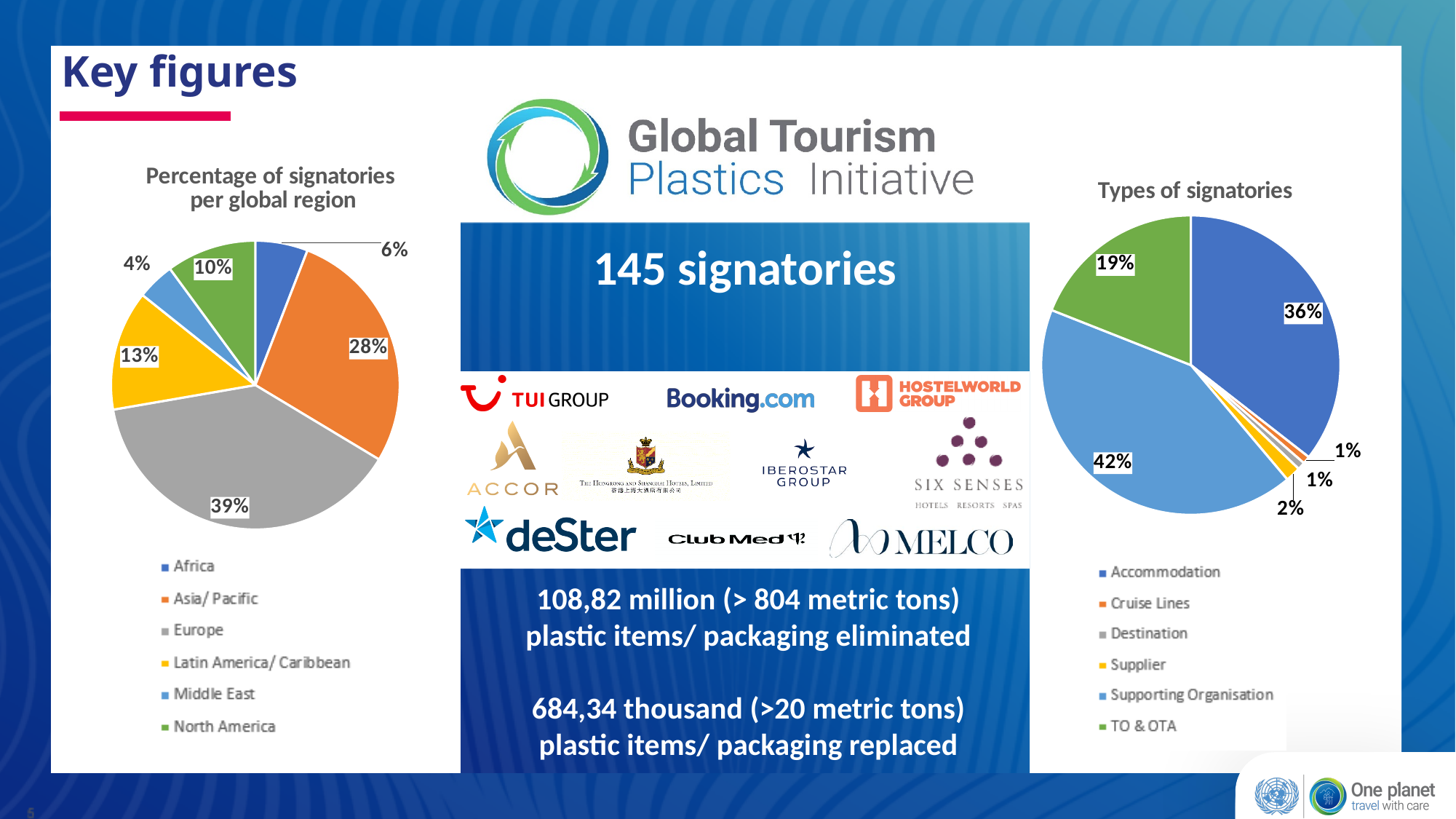
In the 'Percentage of signatories per global region' chart, which region has the smallest share of signatories? Middle East In the 'Percentage of signatories per global region' chart, how many regions are shown? 6 In the 'Types of signatories' chart, what percentage of signatories are TO & OTA? 19% In the 'Types of signatories' chart, what percentage of signatories are Supporting Organisations? 42% In the 'Types of signatories' chart, what is the difference in percentage points between Supporting Organisation and Accommodation? 6 What type of chart is used for 'Types of signatories'? Pie chart In the 'Percentage of signatories per global region' chart, how many percentage points higher is Latin America/ Caribbean than Africa? 7 In the 'Percentage of signatories per global region' chart, what percentage of signatories are from Asia/ Pacific? 28% In the 'Types of signatories' chart, which is larger: Accommodation or TO & OTA? Accommodation In the 'Percentage of signatories per global region' chart, which region has the largest share of signatories? Europe In the 'Percentage of signatories per global region' chart, what percentage of signatories are from Europe? 39% In the 'Types of signatories' chart, which type of signatory has the largest share? Supporting Organisation